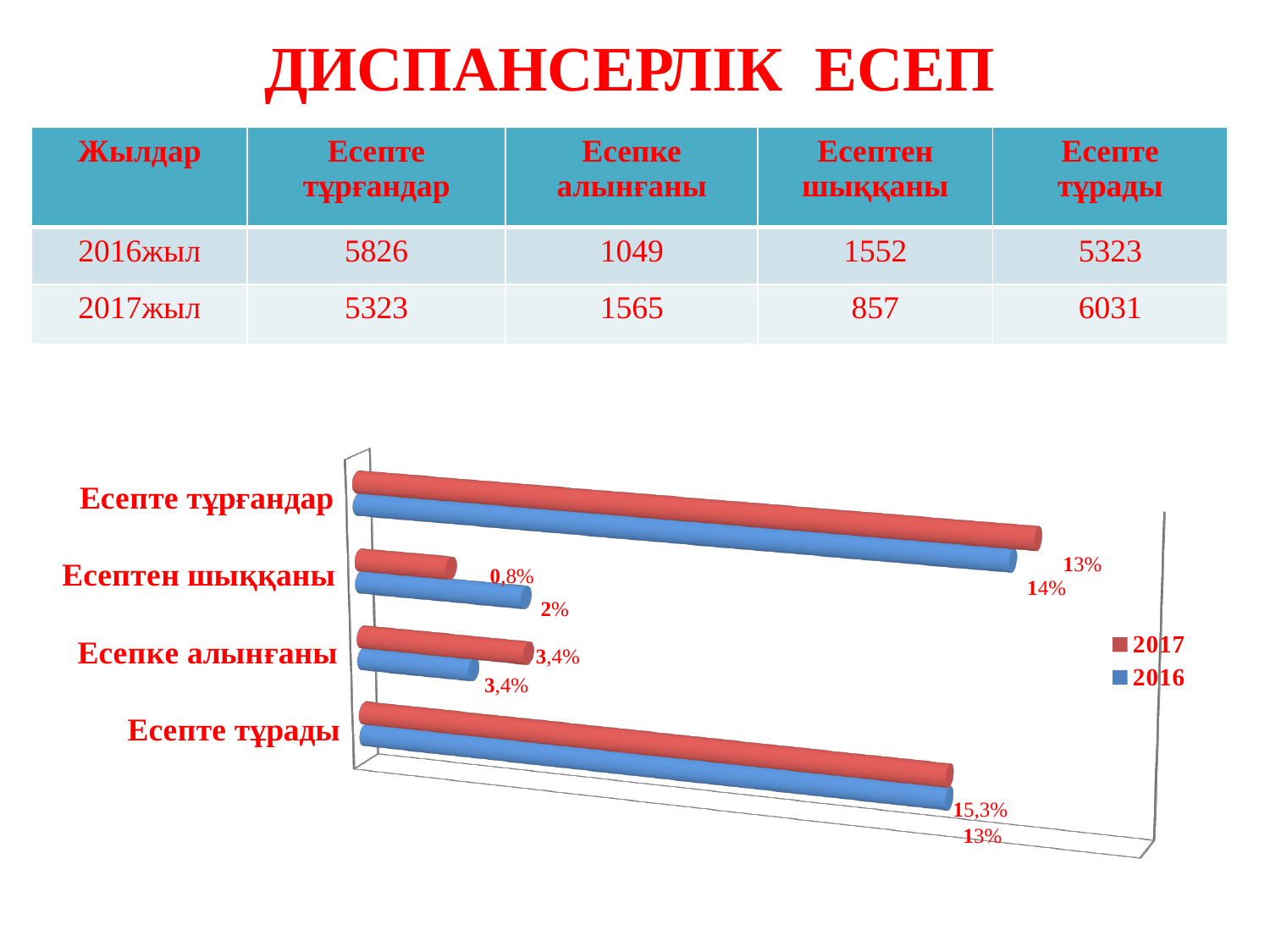
What is the value for 2016 in the Есептен шыққаны category? 2% How many series does the chart legend list? 2 What is the difference between the 2017 and 2016 values for Есепте тұрады? 2,3% How many categories are shown on the chart? 4 For Есептен шыққаны, which year has the larger value, 2016 or 2017? 2016 What is the value for 2016 in the Есепке алынғаны category? 3,4% What is the value for 2017 in the Есептен шыққаны category? 0,8% What kind of chart is shown on the slide? Bar chart What is the value for 2017 in the Есепте тұрады category? 15,3% What is the difference between the 2016 and 2017 values for Есептен шыққаны? 1,2%